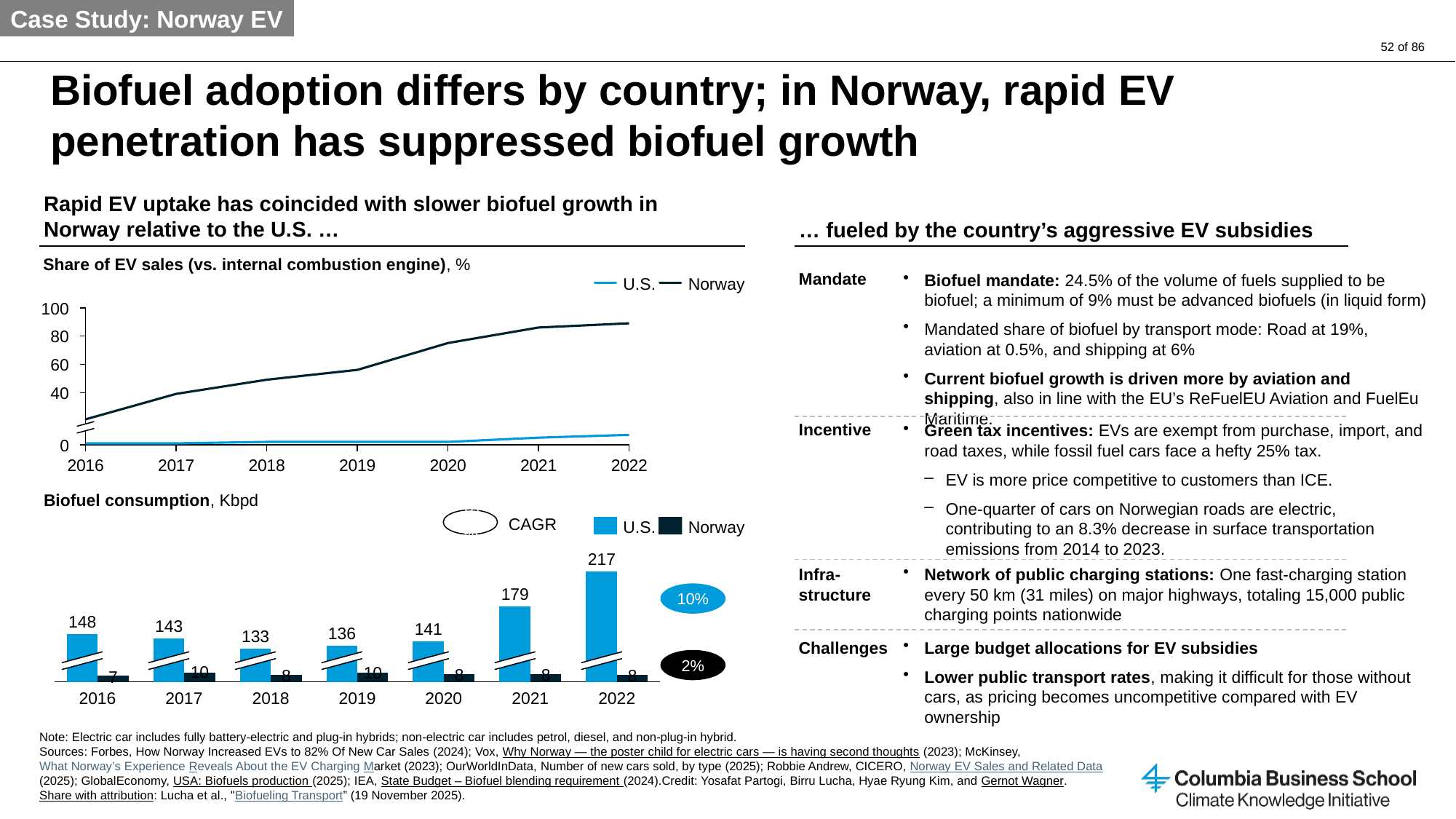
In the 'Biofuel consumption, Kbpd' chart, what is the Norway value for 2017? 10 In the 'Biofuel consumption, Kbpd' chart, what is the U.S. value for 2022? 217 In the 'Biofuel consumption, Kbpd' chart, which year has the lowest U.S. value? 2018 How many series does the legend of the 'Share of EV sales' line chart list? 2 In the 'Biofuel consumption, Kbpd' chart, which year has the highest U.S. value? 2022 In the 'Share of EV sales' line chart, is the Norway value for 2016 greater or less than 40? less In the 'Share of EV sales' line chart, does the Norway line rise or fall from 2016 to 2022? rise In the 'Biofuel consumption, Kbpd' chart, what is the difference between the U.S. values for 2022 and 2021? 38 What kind of chart is the 'Biofuel consumption, Kbpd' chart? bar chart How many years are shown on the x axis of the 'Biofuel consumption, Kbpd' chart? 7 In the 'Biofuel consumption, Kbpd' chart, which year has the larger U.S. value, 2016 or 2017? 2016 In the 'Share of EV sales' line chart, is the Norway value for 2022 greater or less than 80? greater